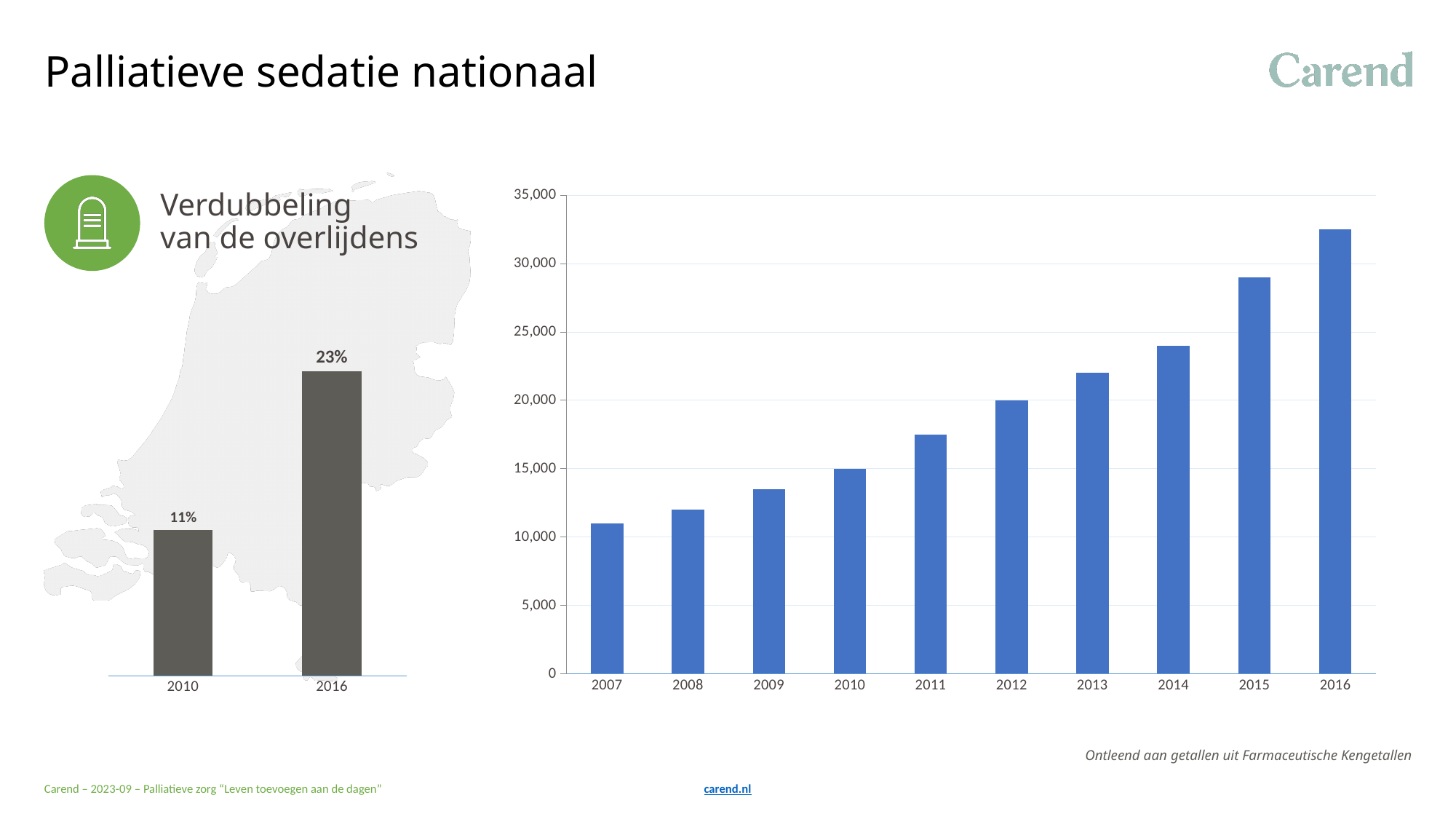
In the right chart, which year has the lowest value? 2007 In the left chart with the map, what is the value for 2016? 23% What kind of chart is the right chart? bar chart In the right chart, do the values rise or fall from 2007 to 2016? rise In the left chart with the map, which year has the higher value, 2010 or 2016? 2016 In the left chart with the map, how many bars are shown? 2 In the right chart, how many years are shown on the x axis? 10 In the left chart with the map, what is the value for 2010? 11% In the right chart, which year has the highest value? 2016 In the left chart with the map, what is the difference between the 2016 and 2010 values? 12% In the right chart, is the value for 2016 greater or less than 30,000? greater In the right chart, is the value for 2009 greater or less than 15,000? less